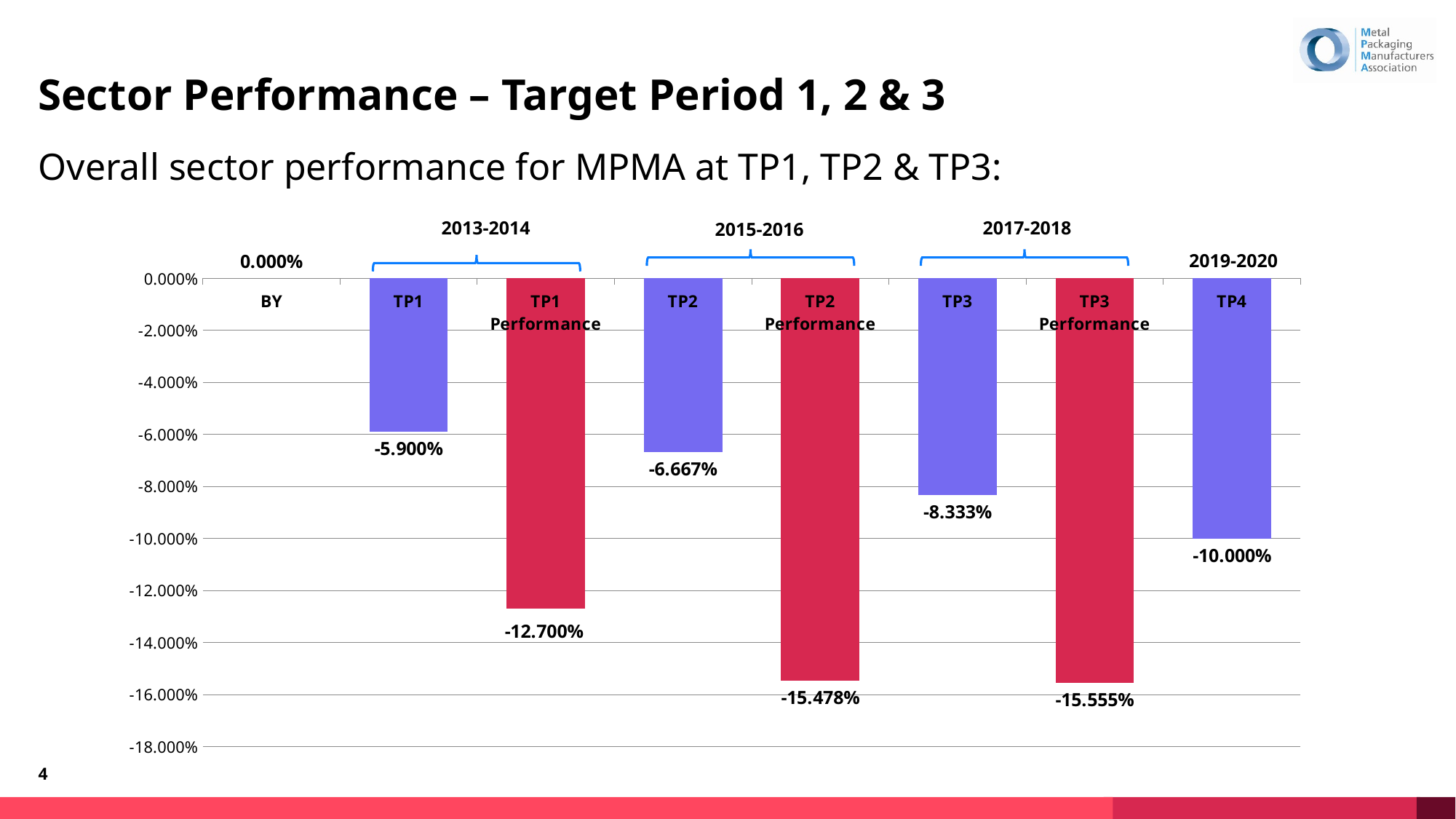
What is the value for TP4? -10.000% What is the difference between the TP1 target and TP1 Performance? 6.800% What is the difference between the TP4 and TP1 values? 4.100% What is the value for TP2 Performance? -15.478% What is the value for TP3? -8.333% How many bars are plotted in the chart? 8 What kind of chart is shown on the slide? Bar chart Which year range is bracketed above the TP3 and TP3 Performance bars? 2017-2018 Which is larger, the value for TP2 or the value for TP2 Performance? TP2 Which category has the highest value? BY What is the value for BY? 0.000% What is the value for TP1? -5.900%